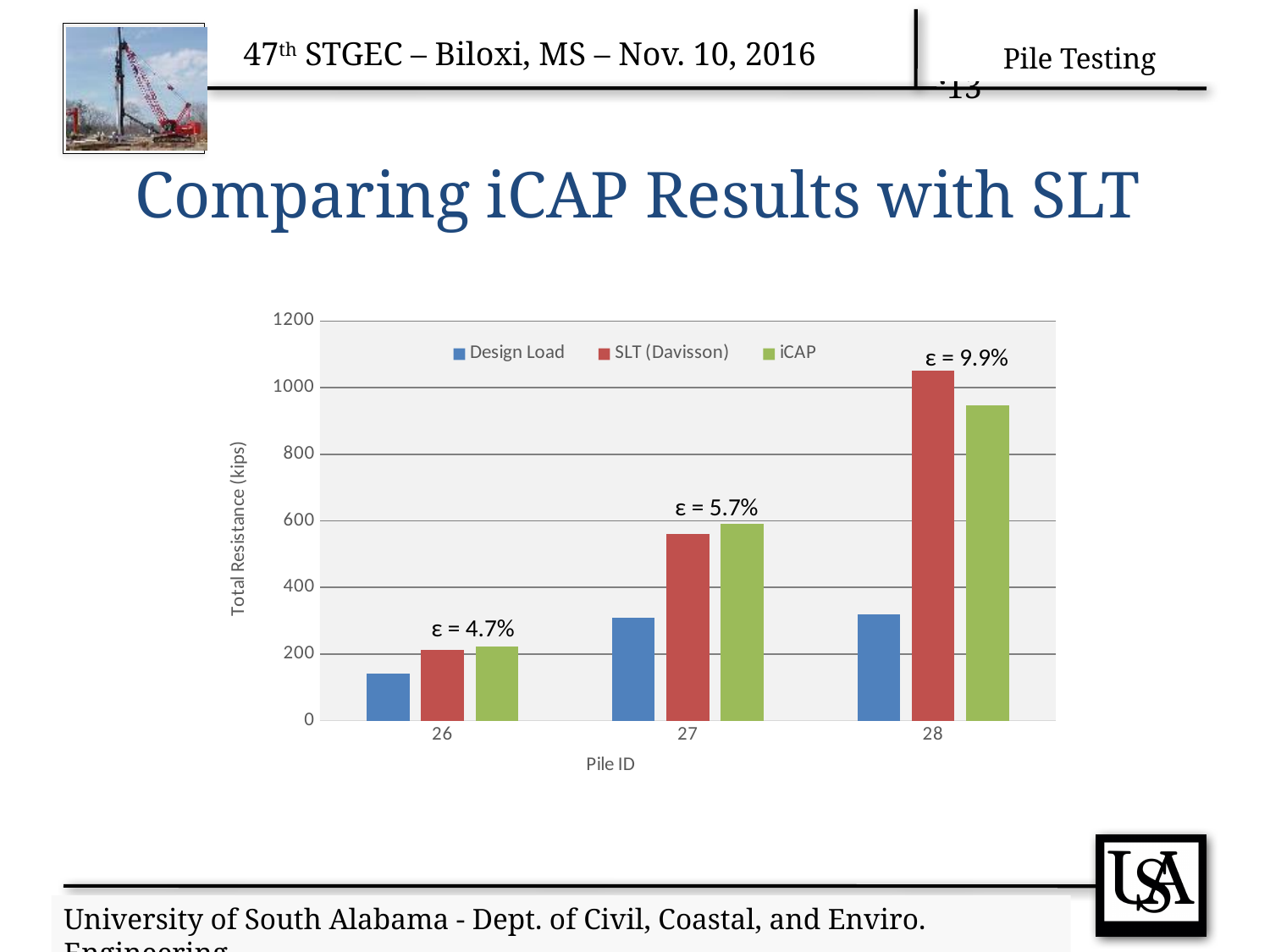
What is the label of the y axis? Total Resistance (kips) Do the SLT (Davisson) values rise or fall from Pile 26 to Pile 28? rise Which Pile ID has the highest SLT (Davisson) value? 28 For Pile 28, which is larger: the SLT (Davisson) value or the iCAP value? SLT (Davisson) Is the Design Load value for Pile 26 greater or less than 200? less Is the SLT (Davisson) value for Pile 28 greater or less than 1000? greater Which Pile ID has the lowest Design Load value? 26 What kind of chart is shown on the slide? bar chart How many series does the legend list? 3 Is the iCAP value for Pile 27 greater or less than 400? greater How many Pile ID categories are shown on the x axis? 3 What is the ε value annotated above the bars for Pile 27? ε = 5.7%